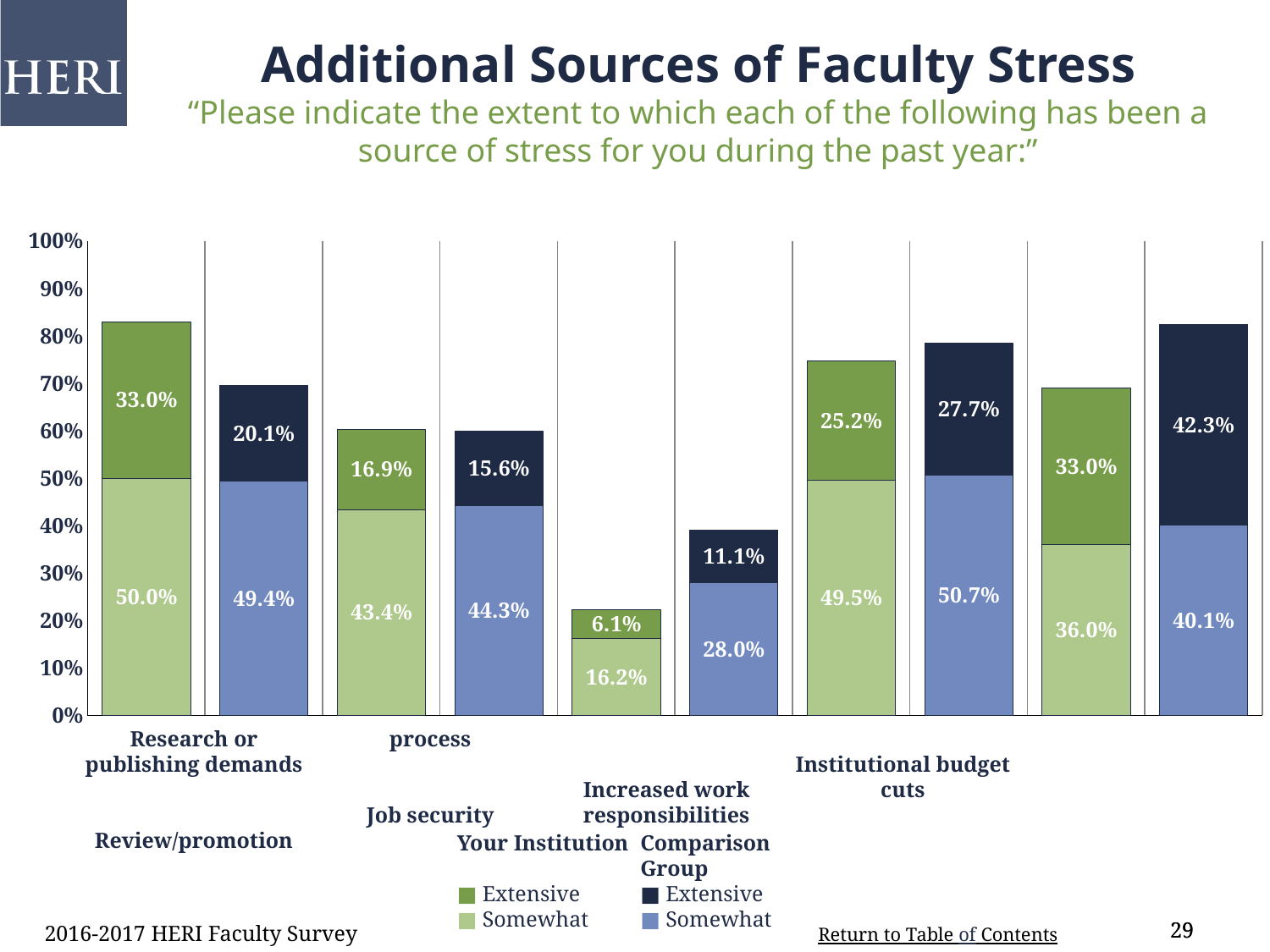
How many entries does the chart legend list? 4 Which source of stress has the lowest 'extensive' value for Your Institution? Job security What type of chart is shown on the slide? Stacked bar chart Which source of stress has the highest 'extensive' value for the Comparison Group? Institutional budget cuts How many sources of stress are shown on the x axis of the chart? 5 What percentage of the Comparison Group reported job security as a somewhat source of stress? 28.0% What is the total percentage of the Comparison Group reporting research or publishing demands as a source of stress (somewhat plus extensive)? 69.5% What is the total percentage of Your Institution faculty reporting job security as a source of stress (somewhat plus extensive)? 22.3% What percentage of faculty at Your Institution reported research or publishing demands as an extensive source of stress? 33.0% What is the difference between the Your Institution and Comparison Group 'extensive' values for research or publishing demands? 12.9% For increased work responsibilities, is the 'somewhat' value larger for Your Institution or the Comparison Group? Comparison Group What percentage of the Comparison Group reported institutional budget cuts as an extensive source of stress? 42.3%